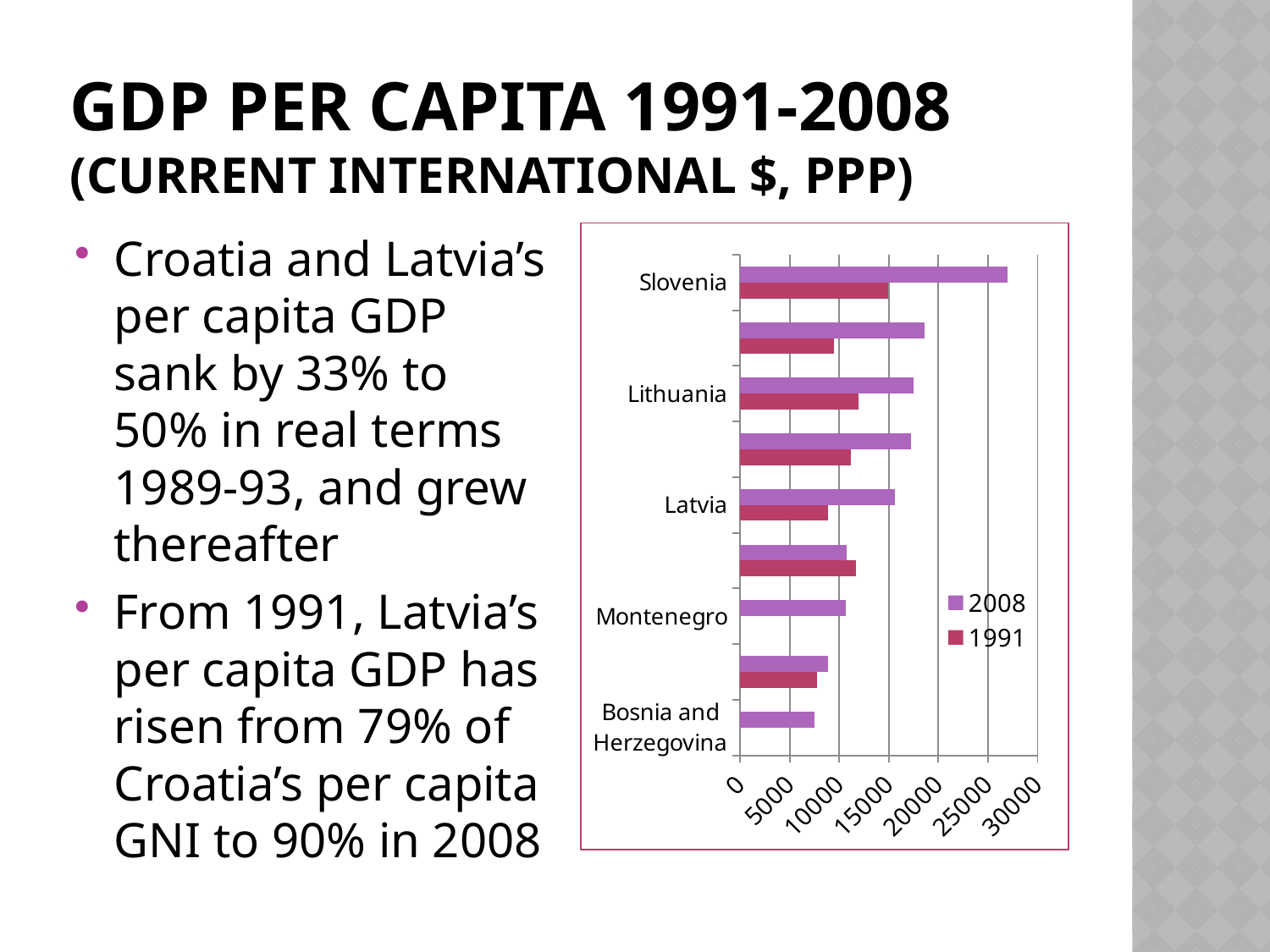
How many series does the chart's legend list? 2 What kind of chart is shown on the slide? bar chart Which labelled country has the lowest GDP per capita in 2008? Bosnia and Herzegovina For Slovenia, which year has the larger GDP per capita, 2008 or 1991? 2008 Is Slovenia's 2008 GDP per capita greater or less than 25000? greater Which two series are listed in the chart's legend? 2008 and 1991 Is Latvia's 1991 GDP per capita greater or less than 10000? less Is Bosnia and Herzegovina's 2008 GDP per capita greater or less than 10000? less Which labelled country has the highest GDP per capita in 2008? Slovenia Which has the larger 2008 GDP per capita, Slovenia or Lithuania? Slovenia